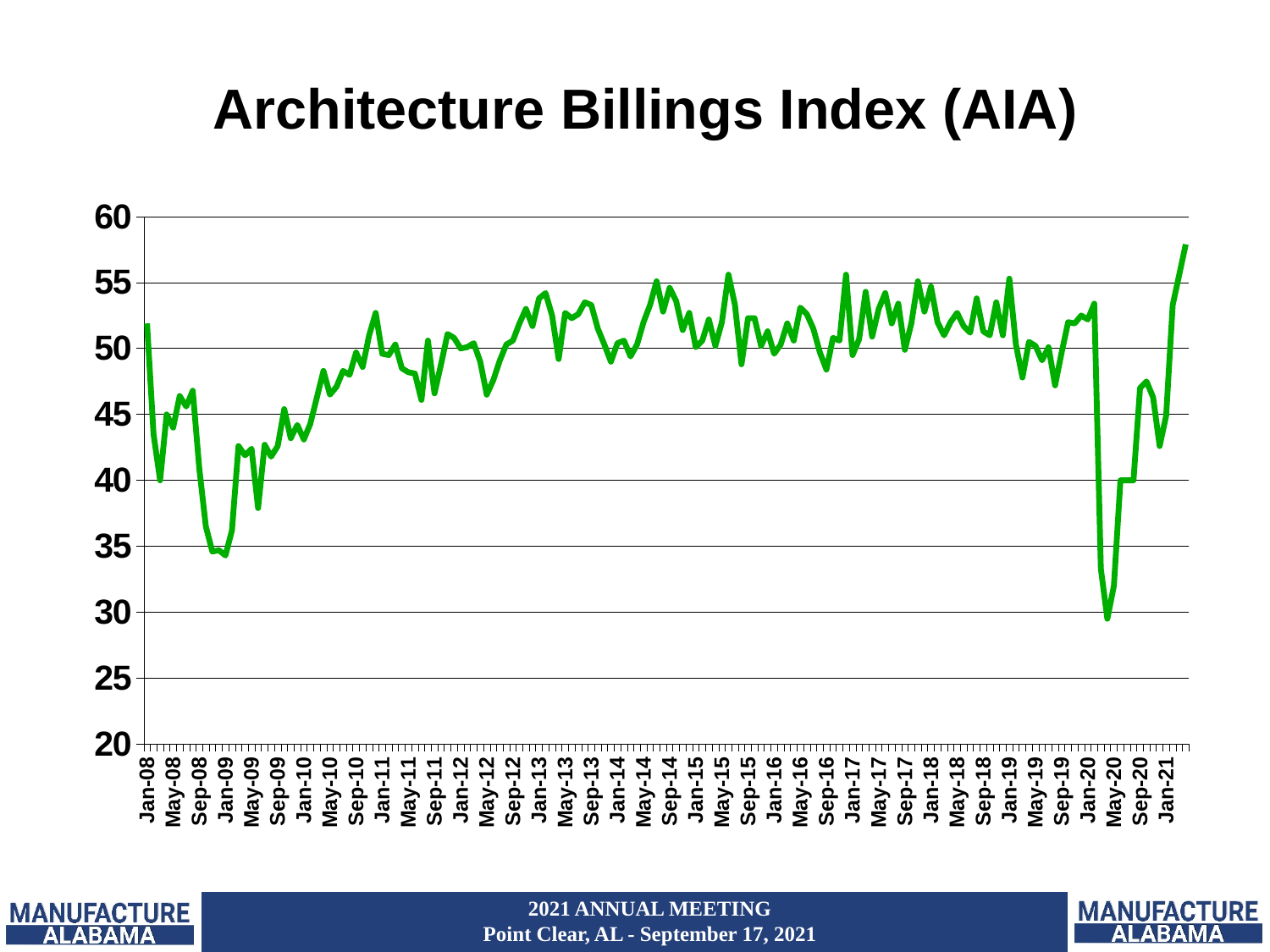
How many data series (lines) are plotted on the chart? 1 What kind of chart is shown on the slide? line chart Does the index rise or fall between Jan-20 and May-20? fall In which year does the line reach its highest value? 2021 Is the value for Sep-20 greater or less than 50? less In which year does the line reach its lowest value? 2020 Is the value for Jan-09 greater or less than 40? less Is the value for Jan-21 greater or less than 55? less What is the title of the chart? Architecture Billings Index (AIA) Does the index rise or fall between Jan-09 and Jan-11? rise